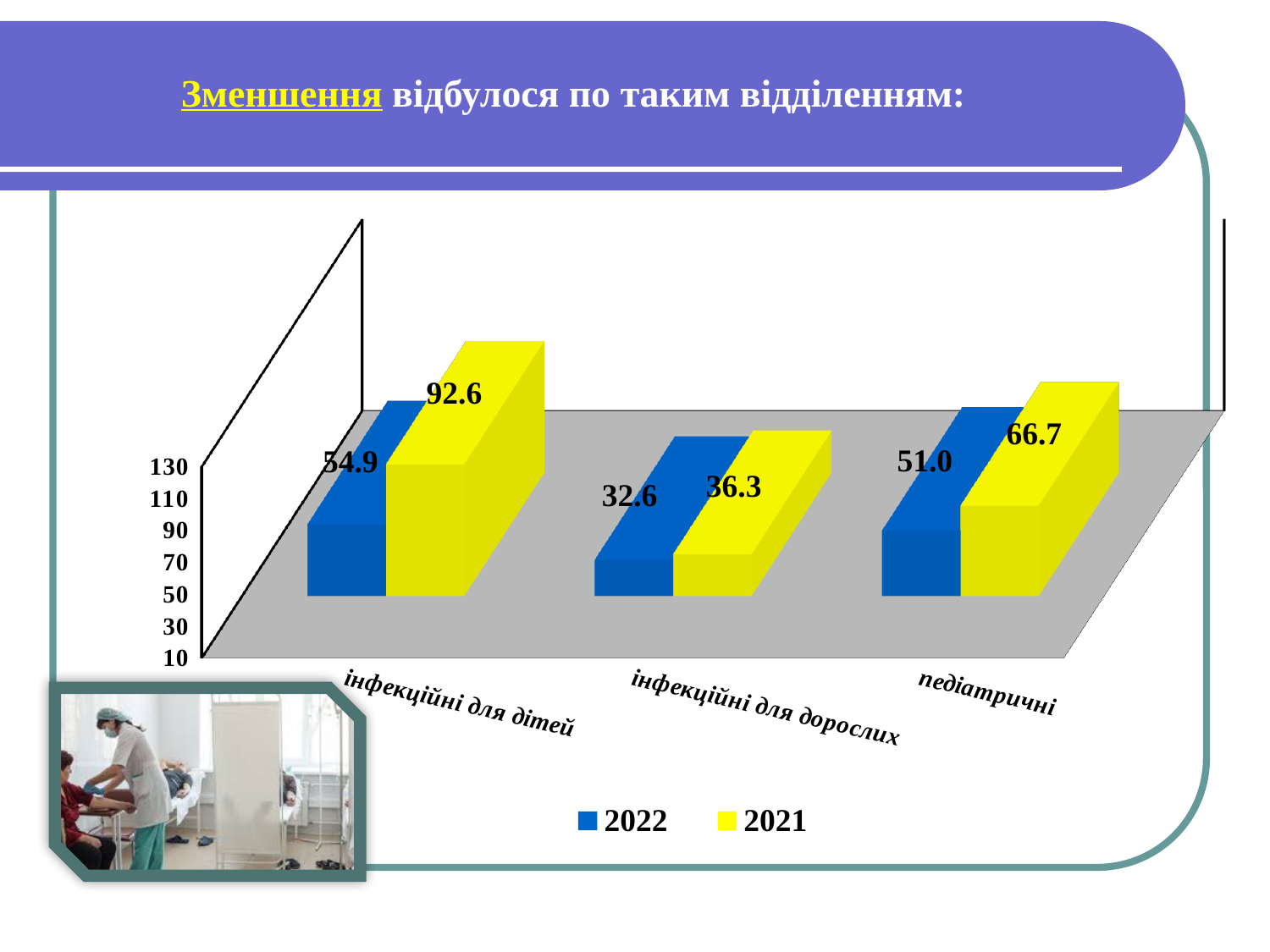
Which category has the highest 2021 value? інфекційні для дітей What kind of chart is shown on the slide? bar chart What is the 2022 value for педіатричні? 51.0 What is the 2021 value for педіатричні? 66.7 What is the difference between the 2021 and 2022 values for інфекційні для дітей? 37.7 What is the 2022 value for інфекційні для дорослих? 32.6 What is the 2021 value for інфекційні для дітей? 92.6 How many categories are shown on the x axis? 3 Which is larger for інфекційні для дорослих: the 2022 value or the 2021 value? 2021 Which category has the lowest 2022 value? інфекційні для дорослих What is the difference between the 2021 and 2022 values for педіатричні? 15.7 How many series does the legend list? 2